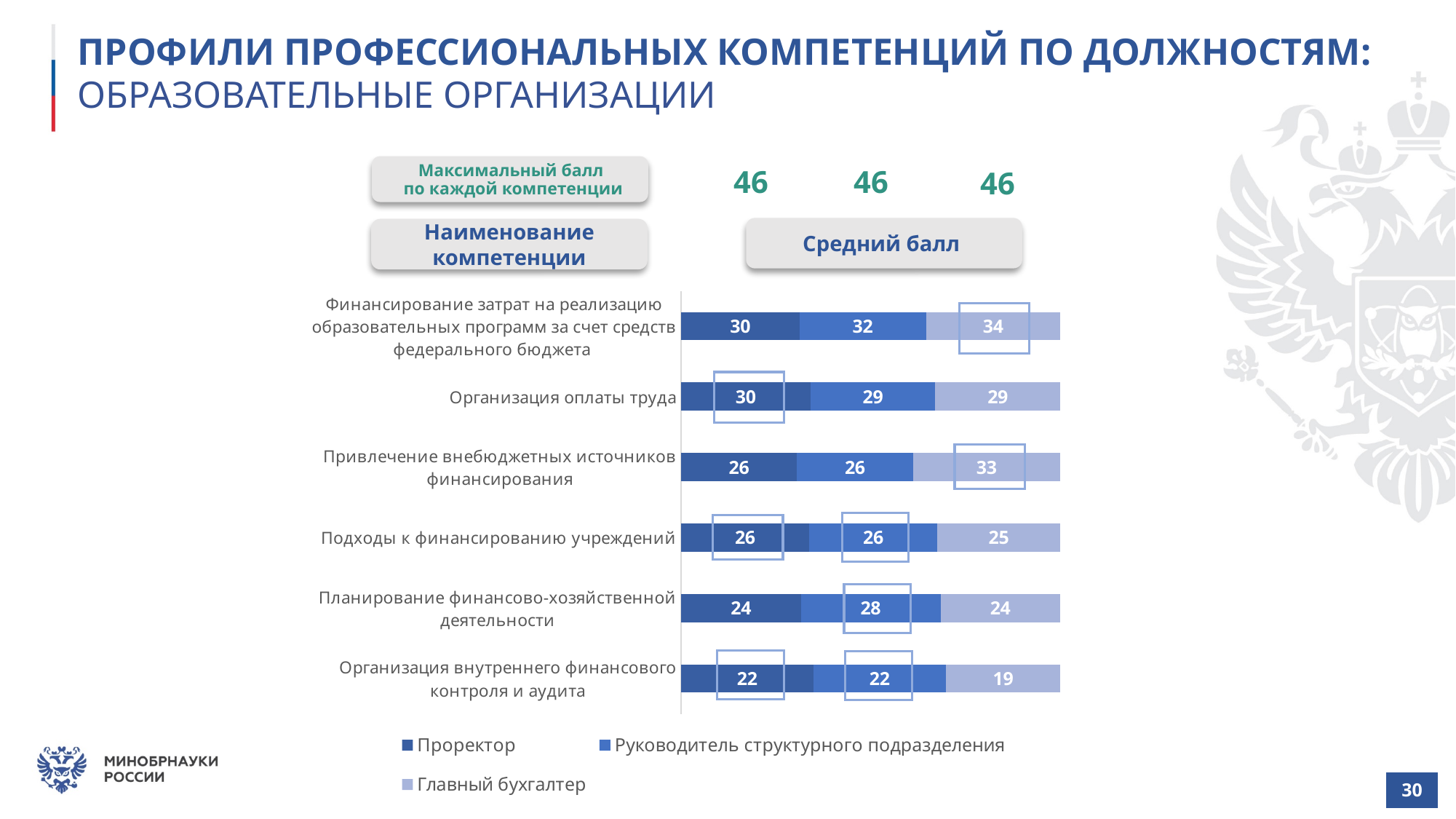
What is the average score for Главный бухгалтер in the competency 'Привлечение внебюджетных источников финансирования'? 33 Which competency has the highest average score for Главный бухгалтер? Финансирование затрат на реализацию образовательных программ за счет средств федерального бюджета Which competency has the lowest average score for Проректор? Организация внутреннего финансового контроля и аудита What is the sum of the three scores shown for 'Организация оплаты труда'? 88 What is the difference between the Главный бухгалтер score and the Проректор score for 'Привлечение внебюджетных источников финансирования'? 7 How many competencies (categories) are plotted in the chart? 6 What maximum score per competency is shown above the chart? 46 What is the average score for Проректор in the competency 'Организация внутреннего финансового контроля и аудита'? 22 For 'Планирование финансово-хозяйственной деятельности', which is larger: the score for Руководитель структурного подразделения or the score for Главный бухгалтер? Руководитель структурного подразделения What type of chart is shown on the slide? Stacked bar chart What is the average score for Руководитель структурного подразделения in the competency 'Планирование финансово-хозяйственной деятельности'? 28 How many series does the legend list? 3